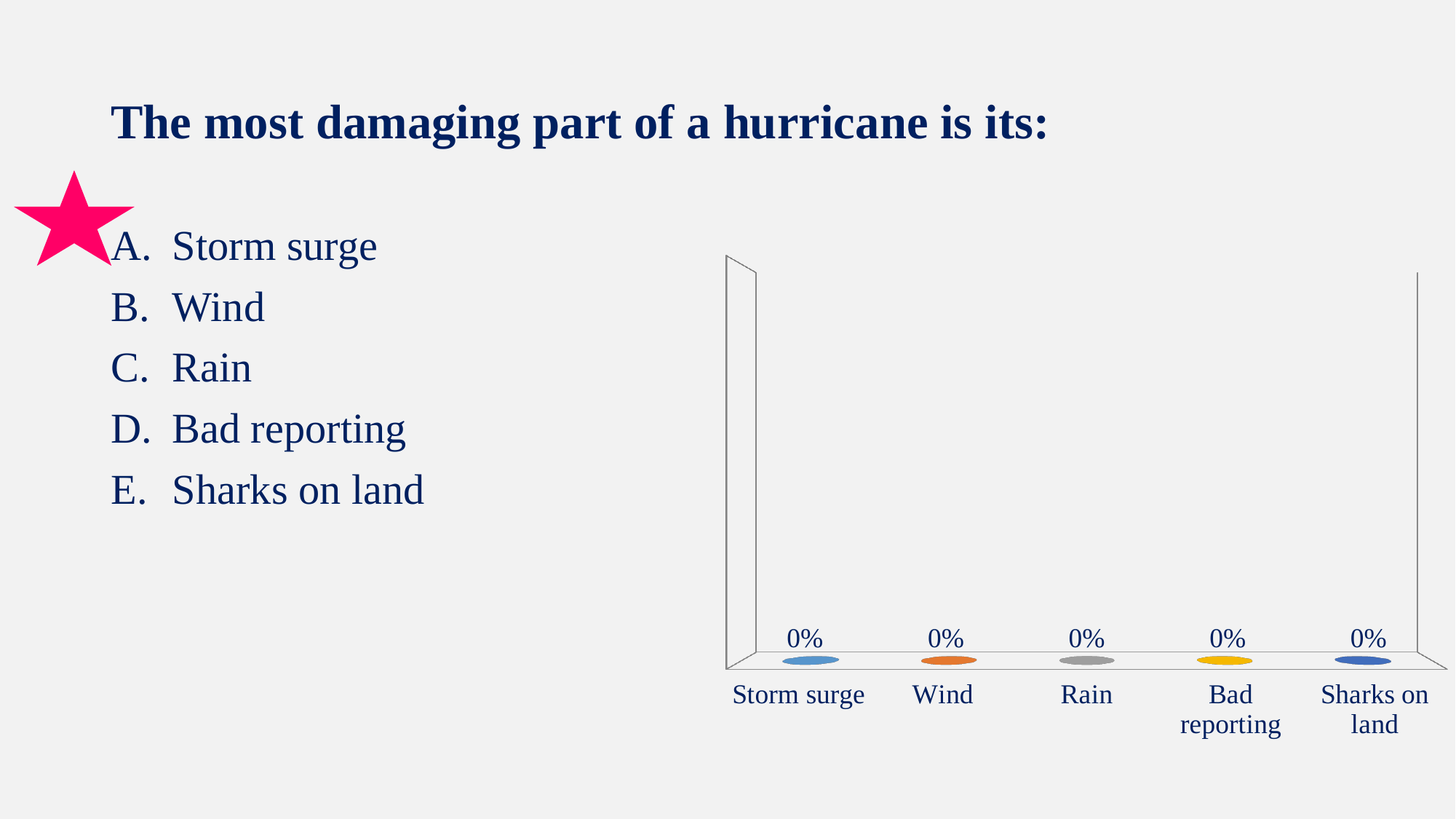
What is the value shown for Bad reporting? 0% What colour is the marker for the Wind category? Orange What is the value shown for Rain? 0% What is the value shown for Sharks on land? 0% What is the value shown for Wind? 0% Which category is labelled furthest to the right on the x axis? Sharks on land What is the difference between the values for Storm surge and Wind? 0% What kind of chart is shown on the slide? Bar chart What is the value shown for Storm surge? 0% How many categories are shown on the chart's x axis? 5 Do all five categories on the chart show the same value? Yes